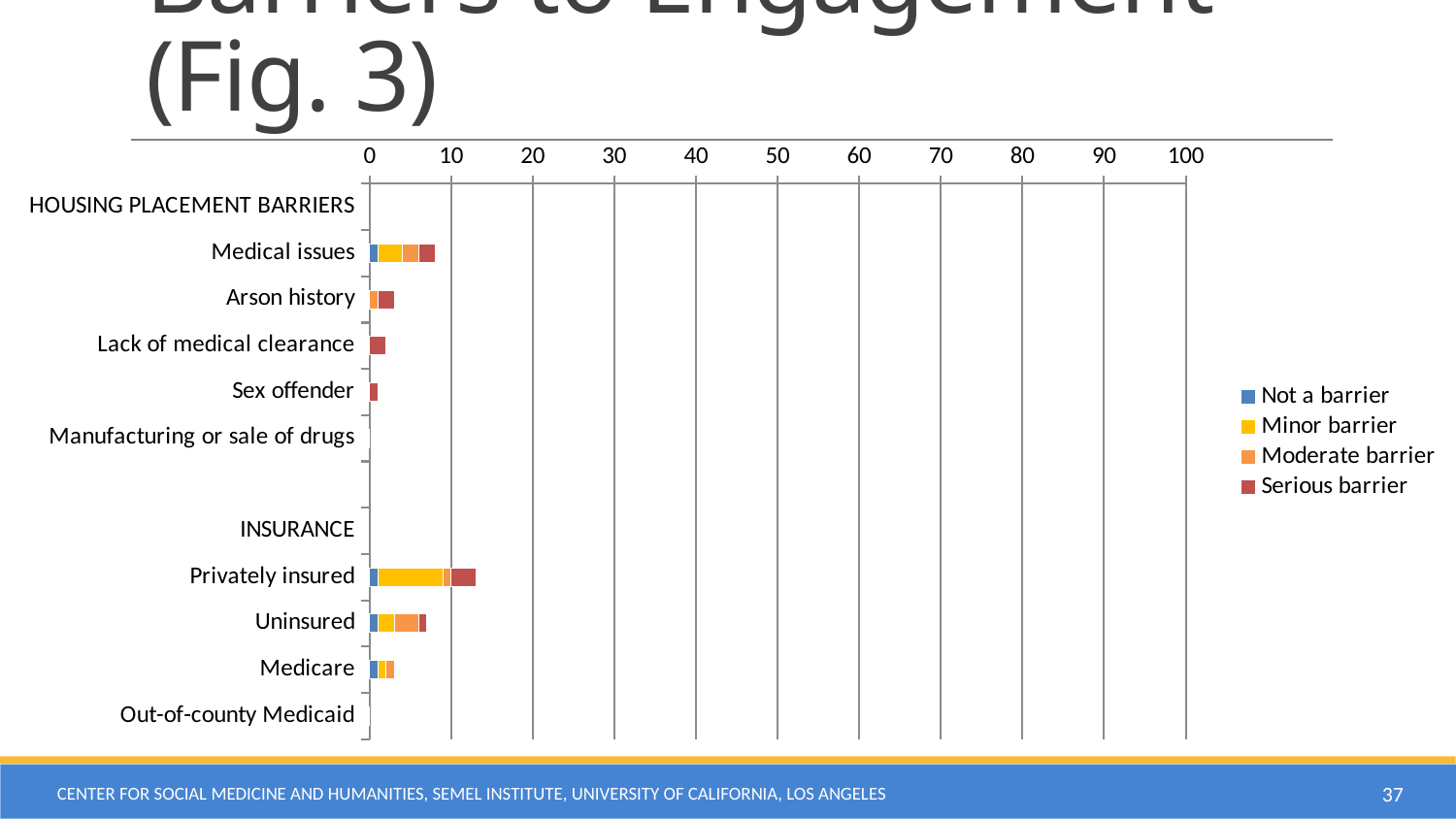
Is the total bar for Uninsured greater or less than 10? less Is the total bar for Medicare greater or less than 10? less Which category has the longest total bar? Privately insured Is the total bar for Medical issues greater or less than 10? less What colour represents the Serious barrier series? red Which has the longer total bar, Uninsured or Medicare? Uninsured What are the four legend entries of the chart? Not a barrier, Minor barrier, Moderate barrier, Serious barrier Which has the longer total bar, Medical issues or Arson history? Medical issues What kind of chart is shown on the slide? bar chart How many series does the legend list? 4 Which has the longer total bar, Privately insured or Medical issues? Privately insured